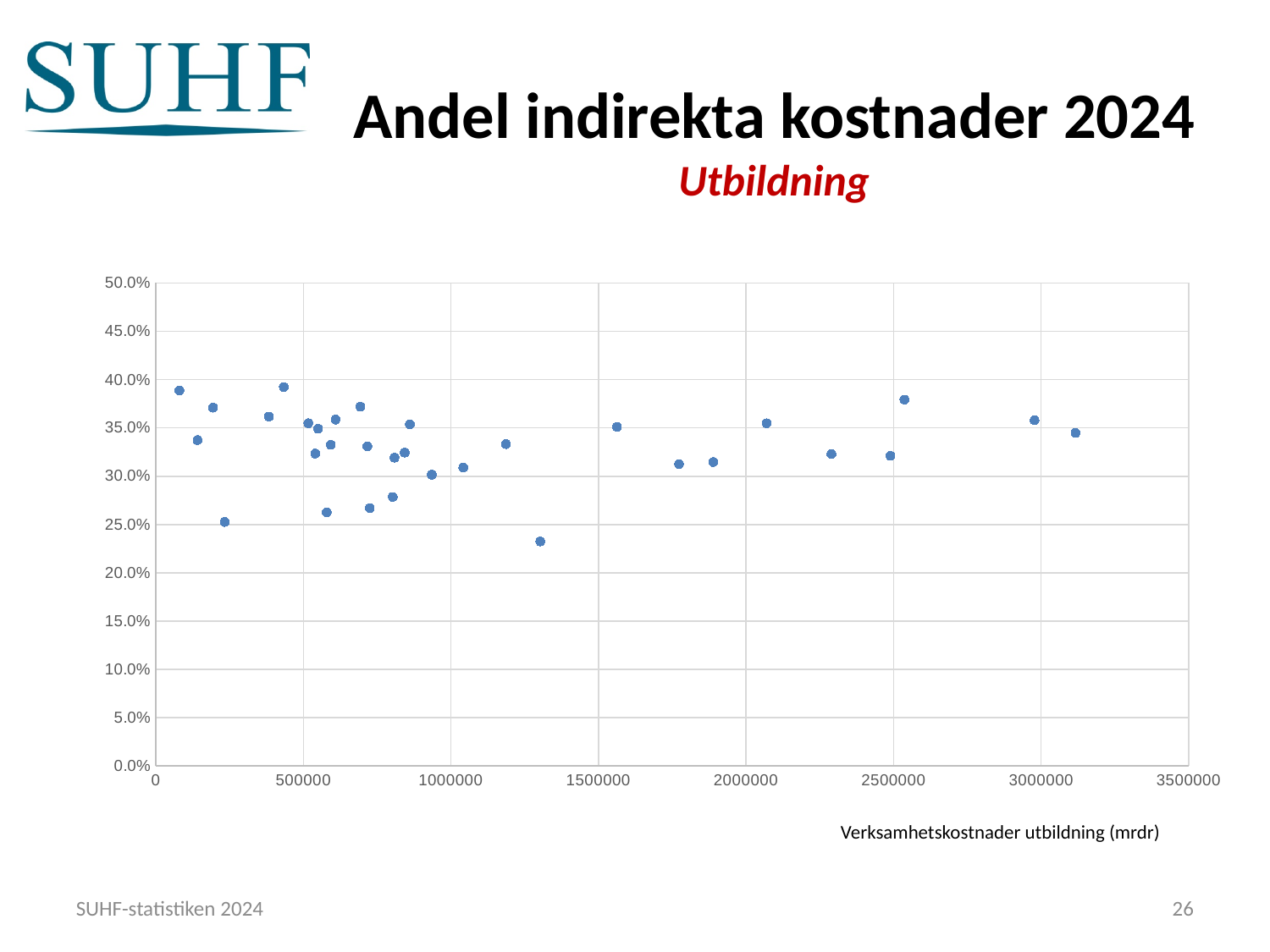
Is the value of the point near x = 1300000 greater or less than 25%? less Is the value of the lowest point on the chart greater or less than 25%? less Is the value of the point with the largest x value (around 3100000) greater or less than 40%? less What is the label of the x axis of the chart? Verksamhetskostnader utbildning (mrdr) What kind of chart is shown on the slide? scatter chart What is the title of the chart on the slide? Andel indirekta kostnader 2024